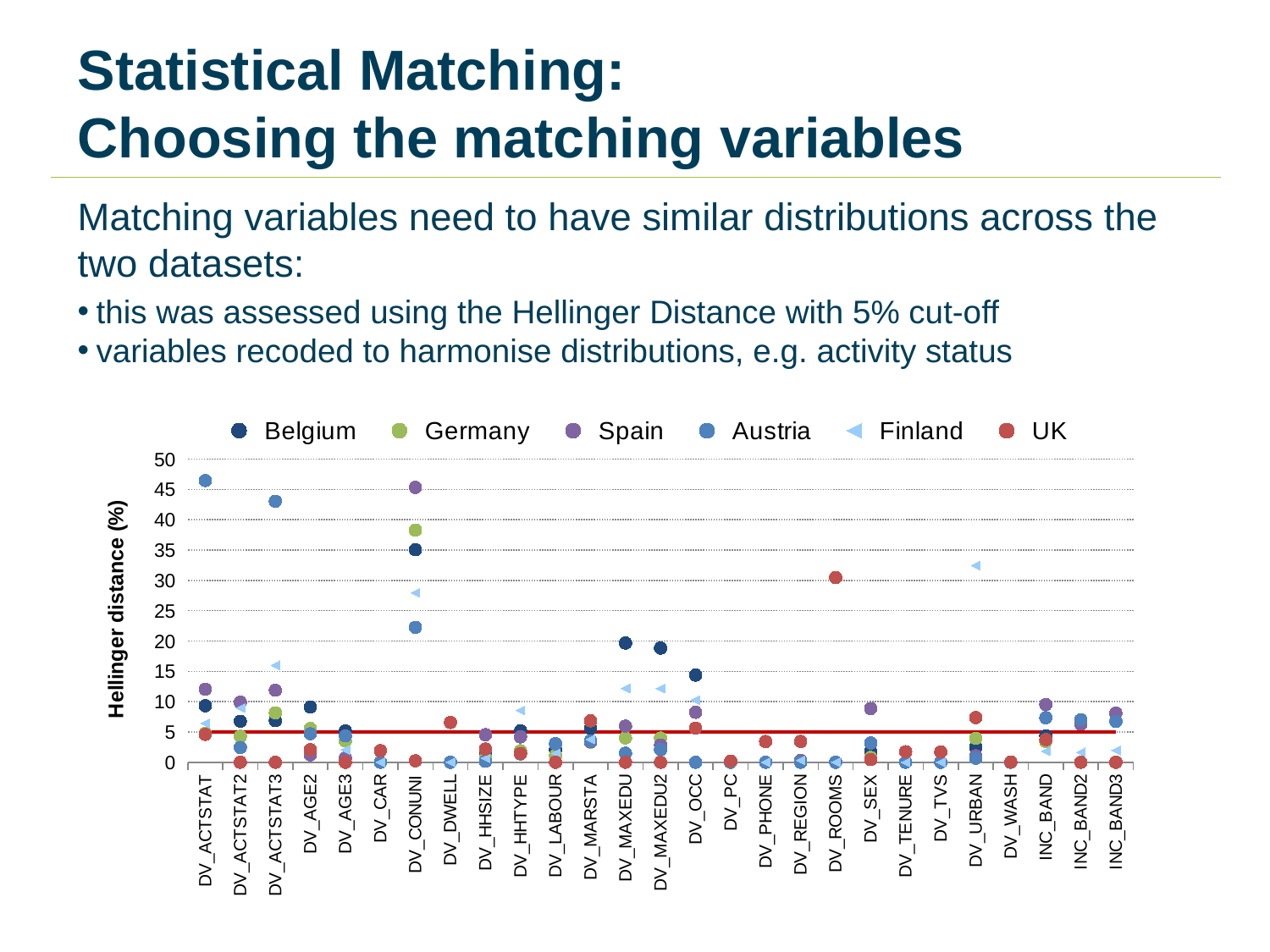
How many variables (categories) are shown along the x axis? 27 Is the value for Austria at DV_ACTSTAT greater or less than 45? greater Is the value for Spain at DV_CONUNI greater or less than 40? greater Is the value for Austria at DV_CONUNI greater or less than 20? greater Which is larger: the value for Austria at DV_ACTSTAT3 or the value for Finland at DV_ACTSTAT3? Austria At what value on the y axis is the red horizontal cut-off line drawn? 5 Which country has the highest Hellinger distance for DV_ACTSTAT3? Austria How many series does the legend list? 6 What kind of chart is shown on the slide? scatter chart What is the title of the y axis? Hellinger distance (%) Which country has the highest Hellinger distance for DV_CONUNI? Spain